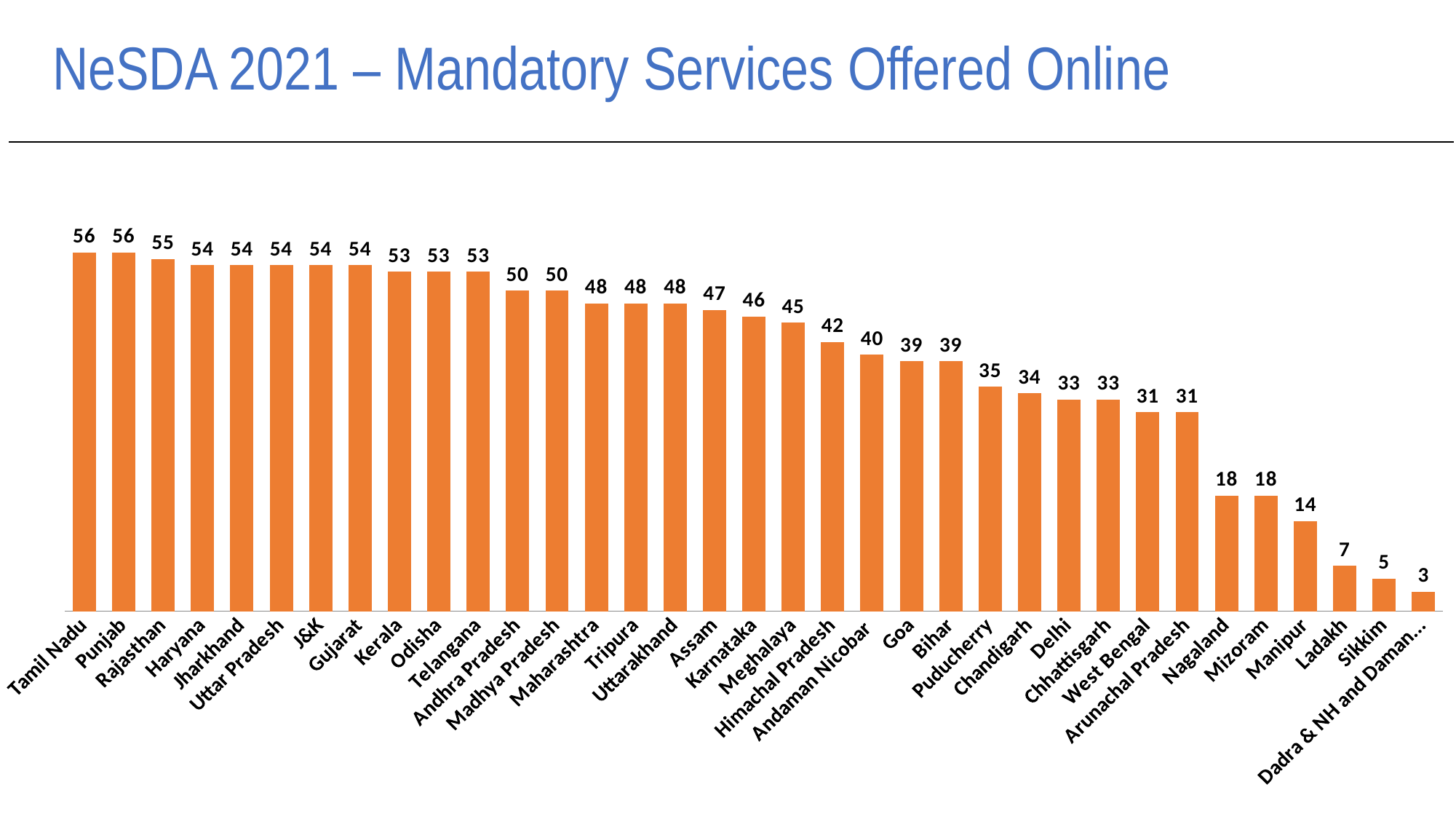
What is the value for Ladakh? 7 Do the values rise or fall moving from left to right along the x axis? fall What is the value for Himachal Pradesh? 42 What is the difference between the values for Tamil Nadu and Sikkim? 51 Which has a higher value, Mizoram or West Bengal? West Bengal Which has a higher value, Assam or Delhi? Assam What is the value for Nagaland? 18 What is the difference between the values for Goa and Manipur? 25 What is the value for Puducherry? 35 What is the value for Kerala? 53 How many states or territories are shown in the chart? 35 What type of chart is shown on the slide? bar chart